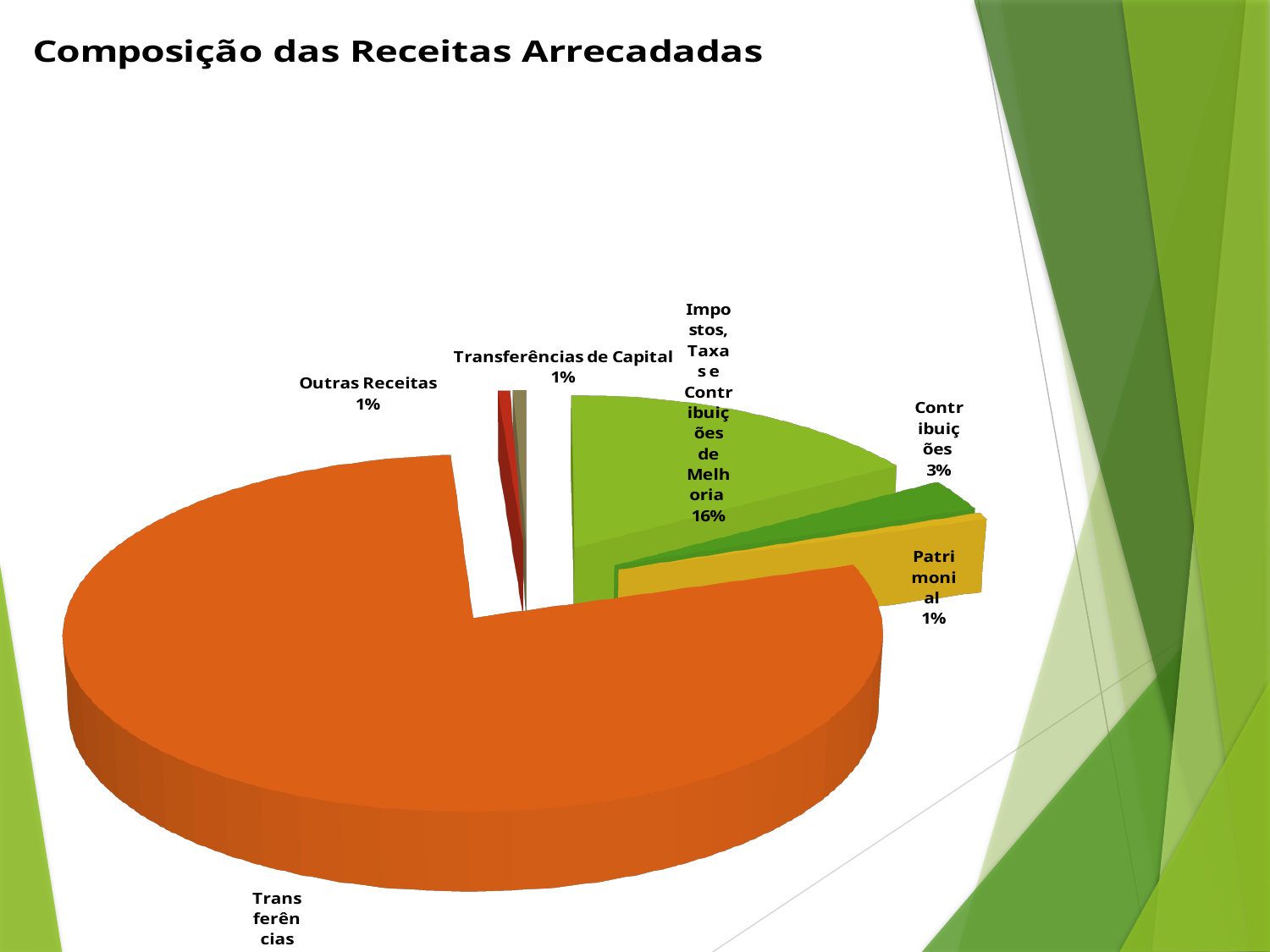
What share of the pie is Transferências de Capital? 1% Which is larger, the share for Impostos, Taxas e Contribuições de Melhoria or the share for Contribuições? Impostos, Taxas e Contribuições de Melhoria Which category has the largest slice of the pie? Transferências What colour is the Transferências slice? orange What is the difference in percentage points between Impostos, Taxas e Contribuições de Melhoria and Contribuições? 13 What share of the pie is Outras Receitas? 1% What share of the pie is Contribuições? 3% How many slices does the pie chart have? 6 What share of the pie is Impostos, Taxas e Contribuições de Melhoria? 16% What share of the pie is Patrimonial? 1% What kind of chart is shown on the slide? pie chart What is the title of the chart? Composição das Receitas Arrecadadas